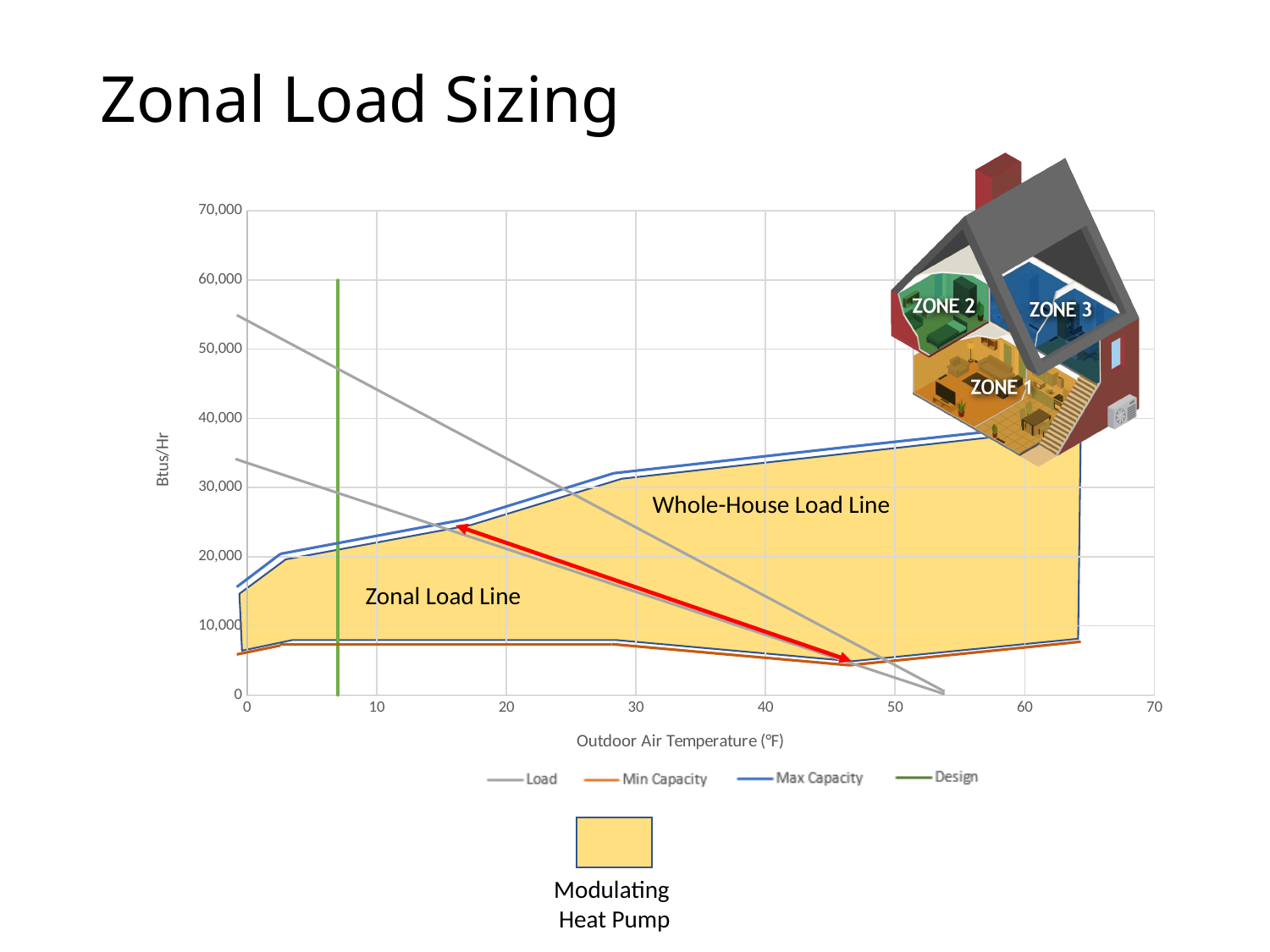
Is the Whole-House Load Line value at 10°F greater or less than 40,000? greater What is the title of the y axis of the chart? Btus/Hr What kind of chart is shown on the slide? line chart Is the Min Capacity value at 30°F greater or less than 10,000? less How many series does the chart legend list? 4 Is the Whole-House Load Line value at 0°F greater or less than 50,000? greater Does the Max Capacity line rise or fall as outdoor air temperature increases? rise At 60°F, which is larger: Max Capacity or Min Capacity? Max Capacity What is the title of the x axis of the chart? Outdoor Air Temperature (°F) Does the Whole-House Load Line rise or fall as outdoor air temperature increases? fall